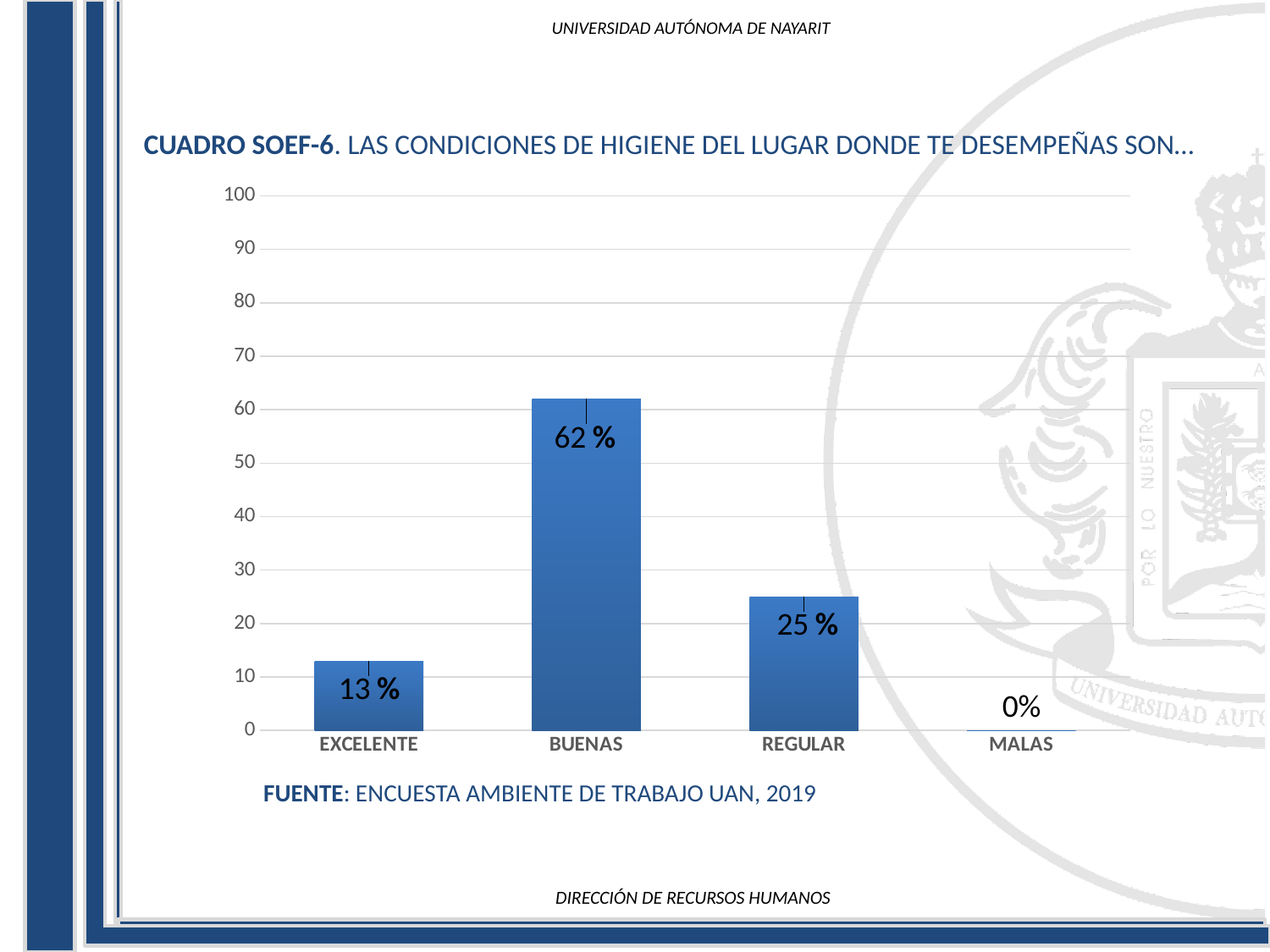
What is the value for MALAS? 0% Which category has the highest value? BUENAS What is the difference between the values for BUENAS and REGULAR? 37 % Which is larger, the value for EXCELENTE or the value for REGULAR? REGULAR What kind of chart is shown on the slide? bar chart Is the value for BUENAS greater or less than 50? greater How many categories are shown on the x axis? 4 Which category has the lowest value? MALAS What source is cited below the chart? ENCUESTA AMBIENTE DE TRABAJO UAN, 2019 What is the value for REGULAR? 25 % What is the value for EXCELENTE? 13 % What is the value for BUENAS? 62 %